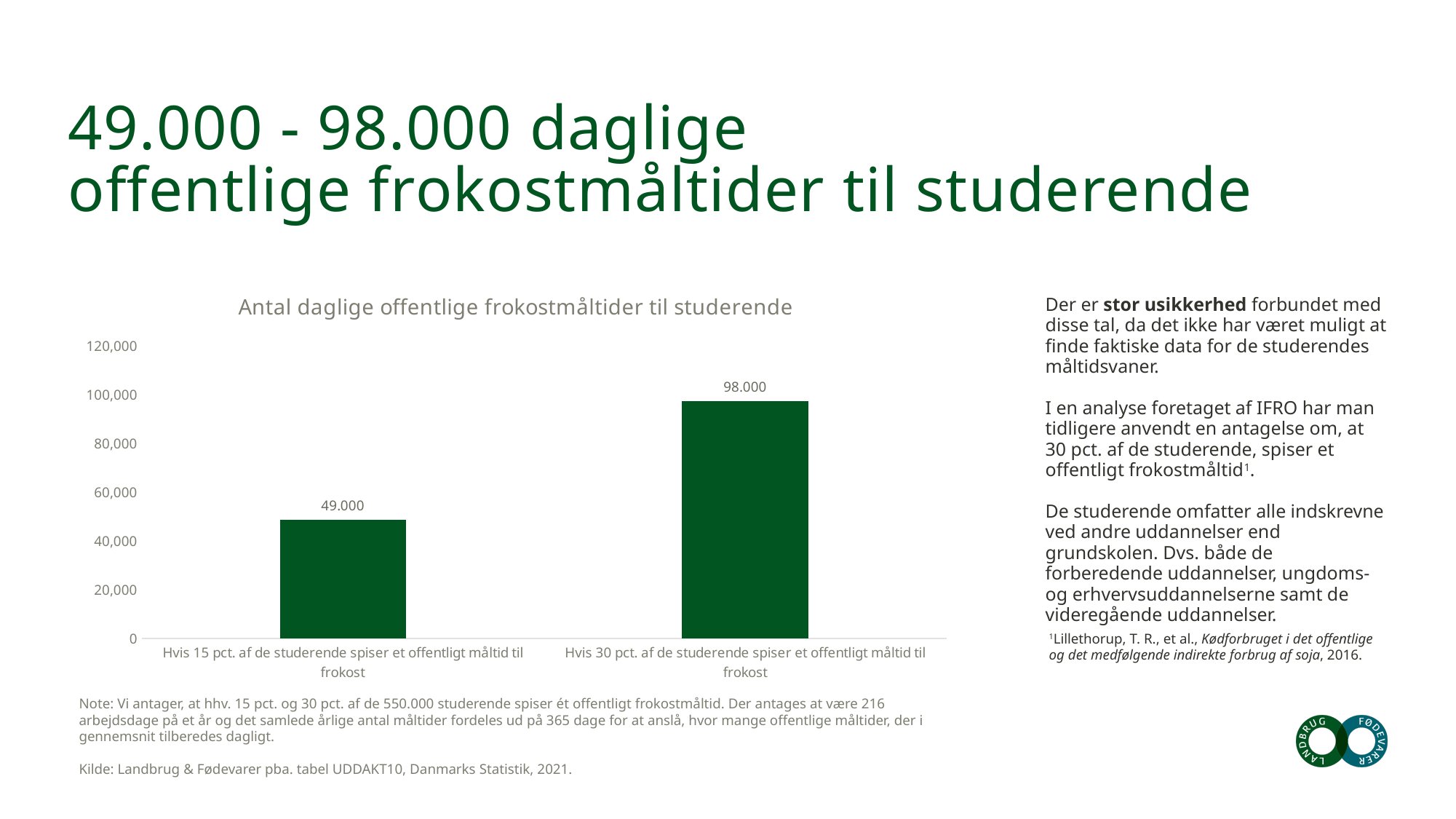
What is the value for 'Hvis 30 pct. af de studerende spiser et offentligt måltid til frokost'? 98.000 Is the value for the 30 pct. scenario greater or less than 80,000? greater Is the value for the 15 pct. scenario greater or less than 60,000? less What is the title of the chart? Antal daglige offentlige frokostmåltider til studerende Which is larger: the value for the 15 pct. scenario or the 30 pct. scenario? Hvis 30 pct. af de studerende spiser et offentligt måltid til frokost What is the difference between the 30 pct. scenario and the 15 pct. scenario? 49.000 What is the value for 'Hvis 15 pct. af de studerende spiser et offentligt måltid til frokost'? 49.000 What is the highest value shown on the vertical axis? 120,000 Which category has the highest value? Hvis 30 pct. af de studerende spiser et offentligt måltid til frokost Which category has the lowest value? Hvis 15 pct. af de studerende spiser et offentligt måltid til frokost How many categories are shown in the chart? 2 What kind of chart is shown on the slide? Bar chart